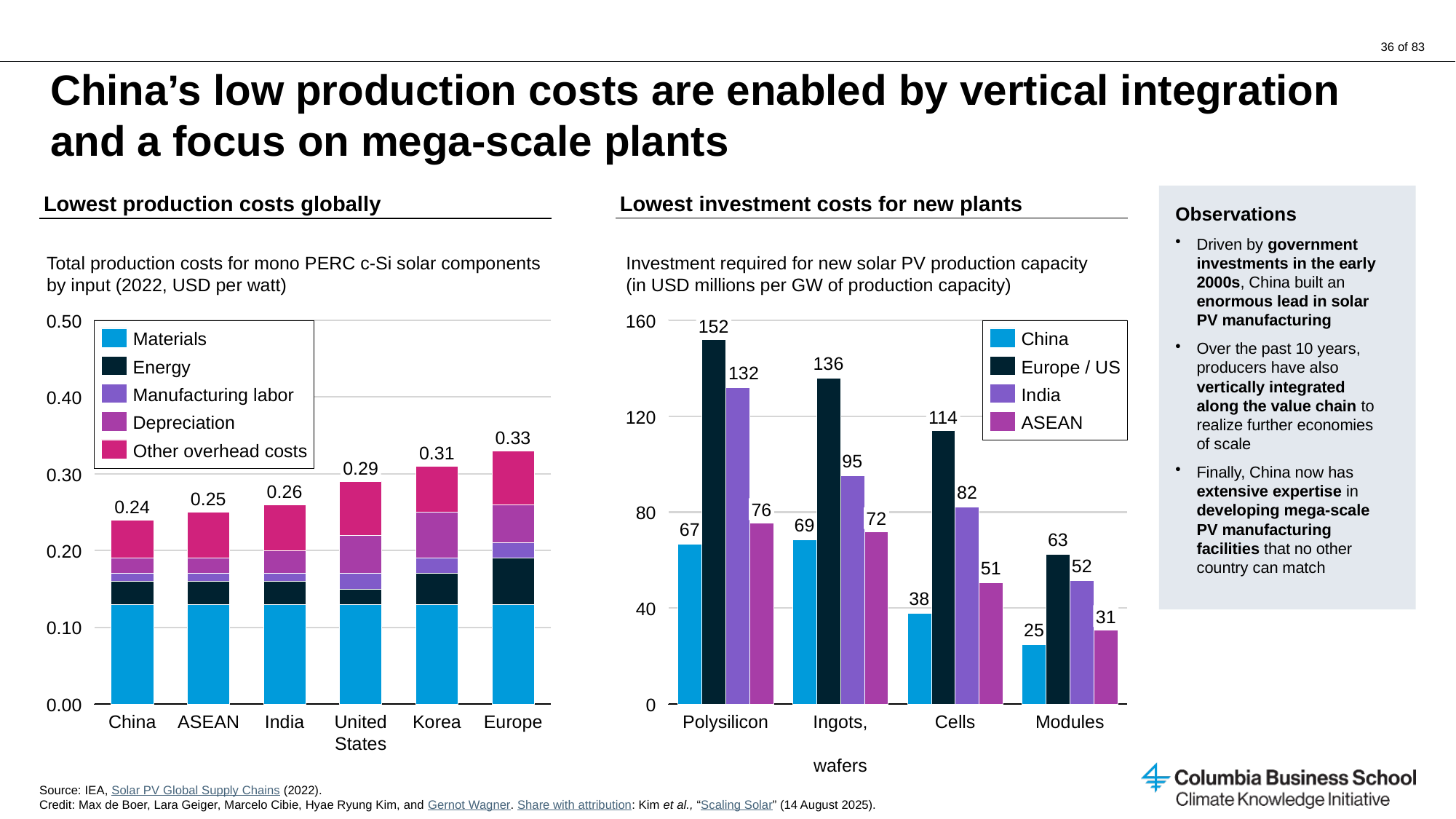
In the 'Lowest investment costs for new plants' chart, which is larger for Modules: India or ASEAN? India In the 'Lowest investment costs for new plants' chart, what is the investment cost for China for Modules? 25 In the 'Lowest investment costs for new plants' chart, what is the difference between India and ASEAN for Ingots, wafers? 23 In the 'Lowest investment costs for new plants' chart, how many product categories are shown on the x axis? 4 In the 'Lowest investment costs for new plants' chart, which region has the highest investment cost for Cells? Europe / US In the 'Lowest production costs globally' chart, how many series does the legend list? 5 In the 'Lowest production costs globally' chart, what is the total production cost for Europe? 0.33 In the 'Lowest production costs globally' chart, do the total production costs rise or fall moving from China to Europe along the x axis? rise In the 'Lowest investment costs for new plants' chart, what is the investment cost for Europe / US for Polysilicon? 152 In the 'Lowest production costs globally' chart, which country or region has the lowest total production cost? China What kind of chart is the 'Lowest investment costs for new plants' chart? bar chart In the 'Lowest production costs globally' chart, what is the difference between the total for Europe and the total for China? 0.09